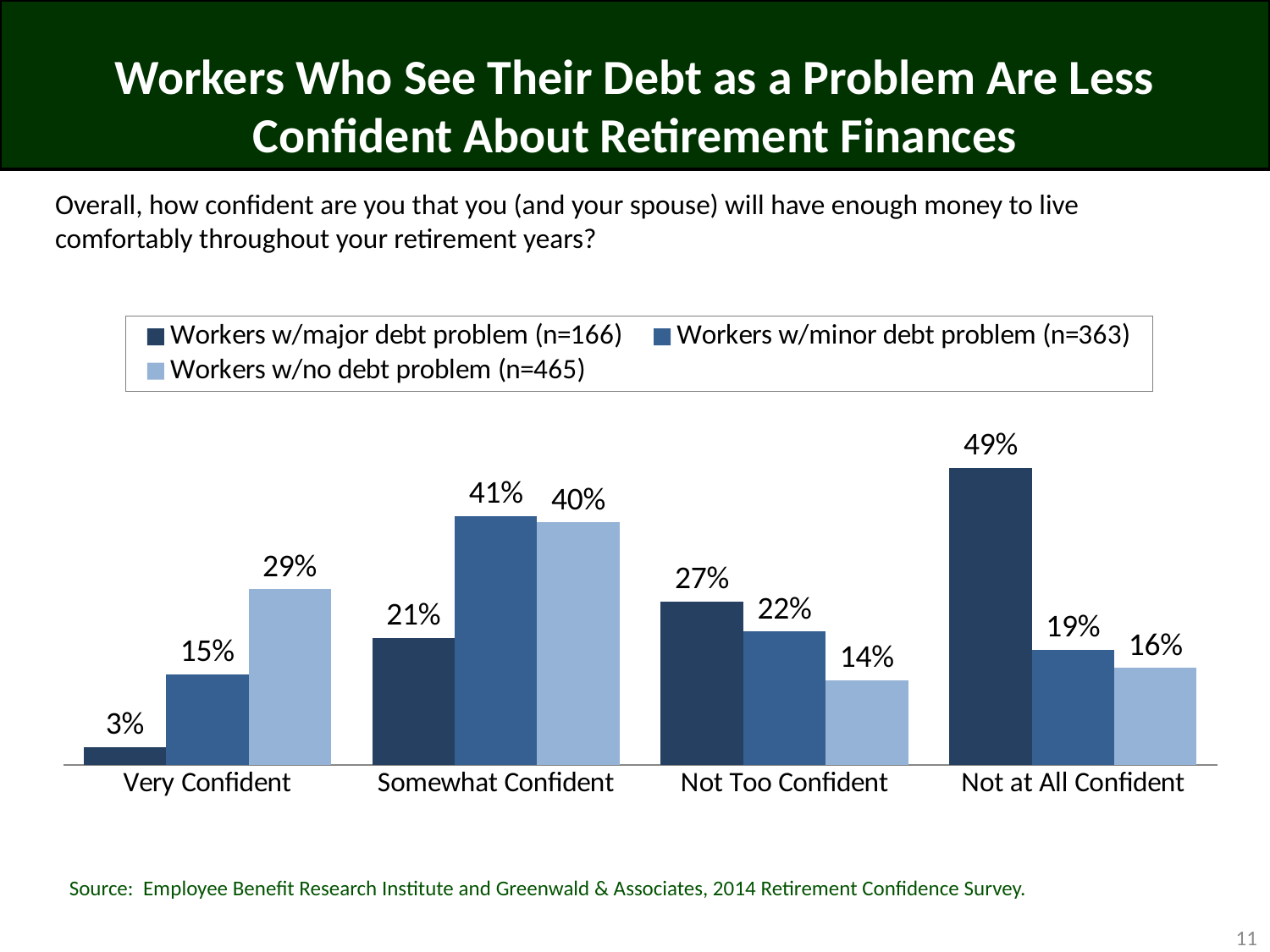
What is the sample size (n) for workers with a minor debt problem shown in the legend? 363 How many confidence categories are shown on the x axis? 4 How many series does the legend list? 3 What kind of chart is shown on the slide? Bar chart What is the difference between workers with no debt problem and workers with a major debt problem in the Very Confident category? 26 percentage points What percentage of workers with a major debt problem are Very Confident? 3% Do the values for workers with no debt problem rise or fall from Somewhat Confident to Not Too Confident? Fall Which confidence category has the lowest value for workers with no debt problem? Not Too Confident What percentage of workers with no debt problem are Somewhat Confident? 40% Which confidence category has the highest value for workers with a major debt problem? Not at All Confident In the Not at All Confident category, which group has the larger value: workers with a minor debt problem or workers with no debt problem? Workers w/minor debt problem What percentage of workers with a minor debt problem are Not Too Confident? 22%